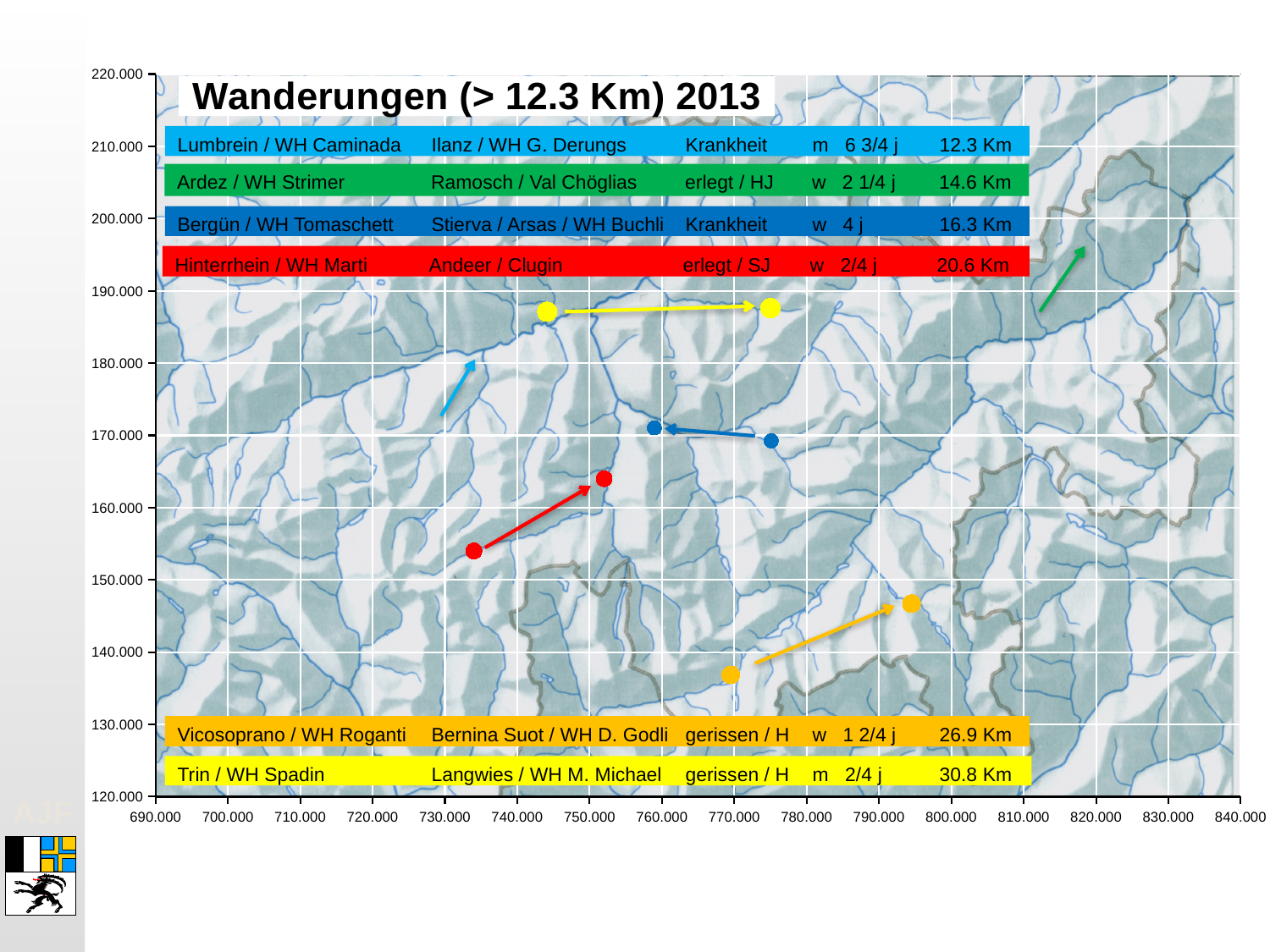
What kind of chart is shown on the slide? scatter chart What colour is the row for the Hinterrhein / WH Marti migration? red Which migration has the longest distance? Trin / WH Spadin What distance is given for the migration starting at Ardez / WH Strimer? 14.6 Km What distance is given for the migration starting at Trin / WH Spadin? 30.8 Km Is the y-coordinate of the yellow points (Trin / WH Spadin migration) greater or less than 180.000? greater What distance is given for the migration starting at Hinterrhein / WH Marti? 20.6 Km What is the title of the chart? Wanderungen (> 12.3 Km) 2013 Which migration is longer: Bergün / WH Tomaschett or Vicosoprano / WH Roganti? Vicosoprano / WH Roganti How many migrations (Wanderungen) are listed in the coloured rows on the chart? 6 What is the difference in distance between the Trin / WH Spadin migration and the Lumbrein / WH Caminada migration? 18.5 Km Which migration has the shortest distance? Lumbrein / WH Caminada